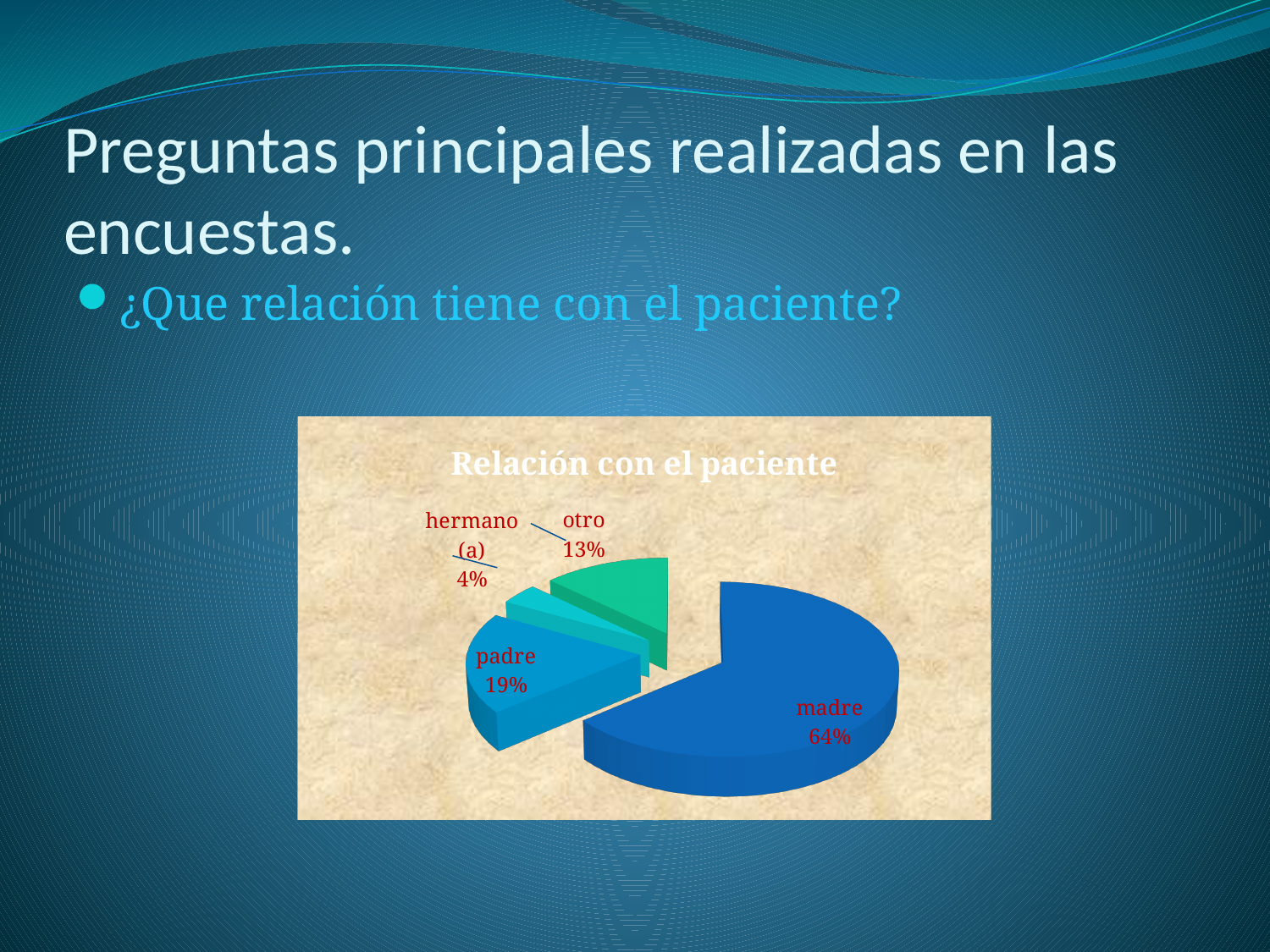
What is the title of the chart? Relación con el paciente Which category has the largest slice of the pie? madre Which is larger, the share for otro or the share for hermano (a)? otro What share of the pie does otro represent? 13% What is the difference in percentage points between padre and otro? 6 How many categories are shown in the pie chart? 4 What is the difference in percentage points between madre and padre? 45 What kind of chart is shown on the slide? pie chart What share of the pie does hermano (a) represent? 4% What share of the pie does padre represent? 19% Which category has the smallest slice of the pie? hermano (a)